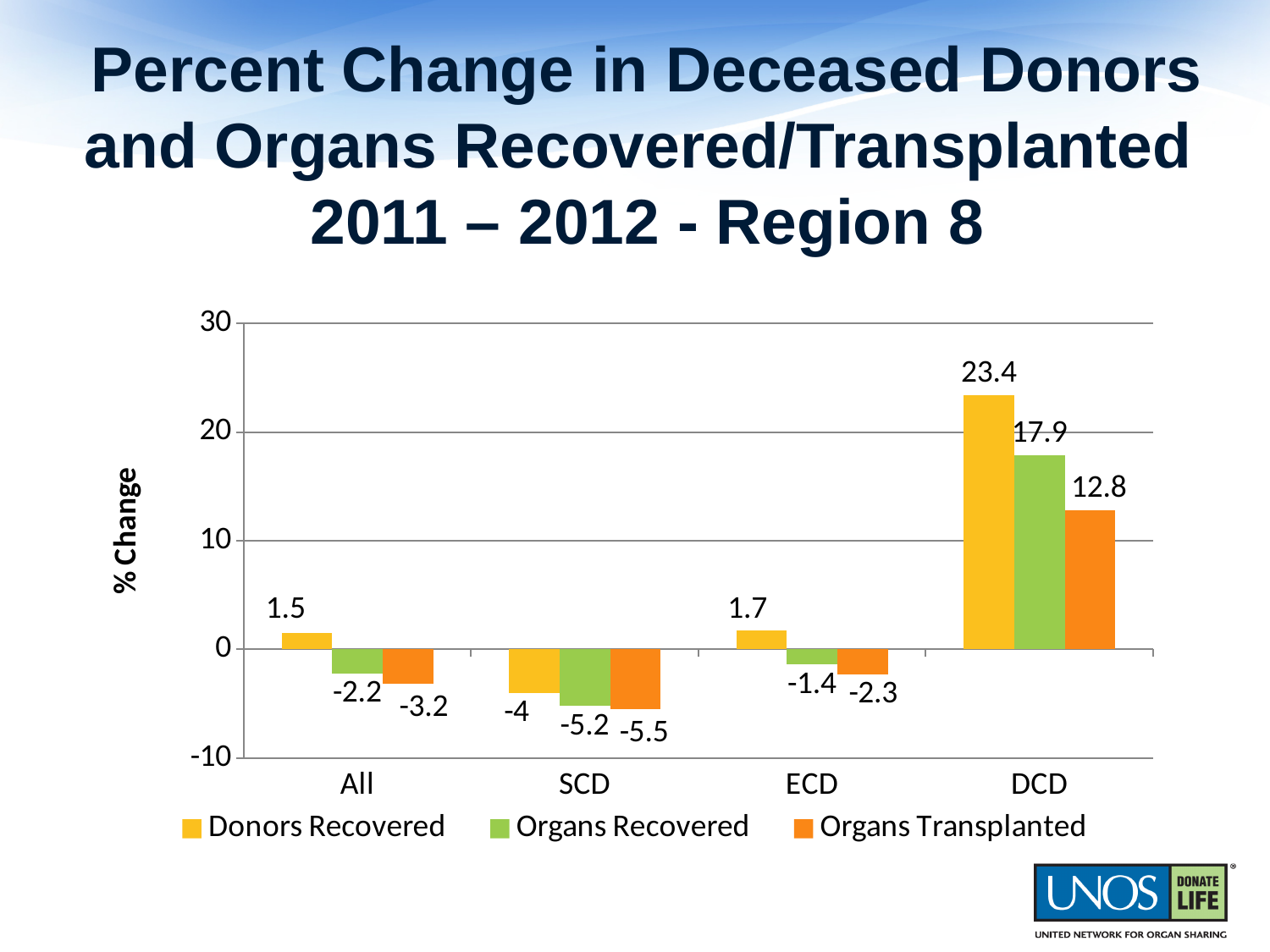
Is the value for Organs Transplanted for DCD greater or less than 10? greater How many categories are shown on the x axis? 4 What is the percent change in Donors Recovered for All? 1.5 What is the difference between Donors Recovered and Organs Transplanted for DCD? 10.6 What is the percent change in Organs Transplanted for SCD? -5.5 What is the percent change in Donors Recovered for DCD? 23.4 Which category has the highest value for Organs Recovered? DCD Which is larger, Donors Recovered for ECD or Donors Recovered for All? Donors Recovered for ECD What kind of chart is shown on the slide? Bar chart What is the percent change in Organs Recovered for ECD? -1.4 Which category has the lowest value for Donors Recovered? SCD How many series does the legend list? 3